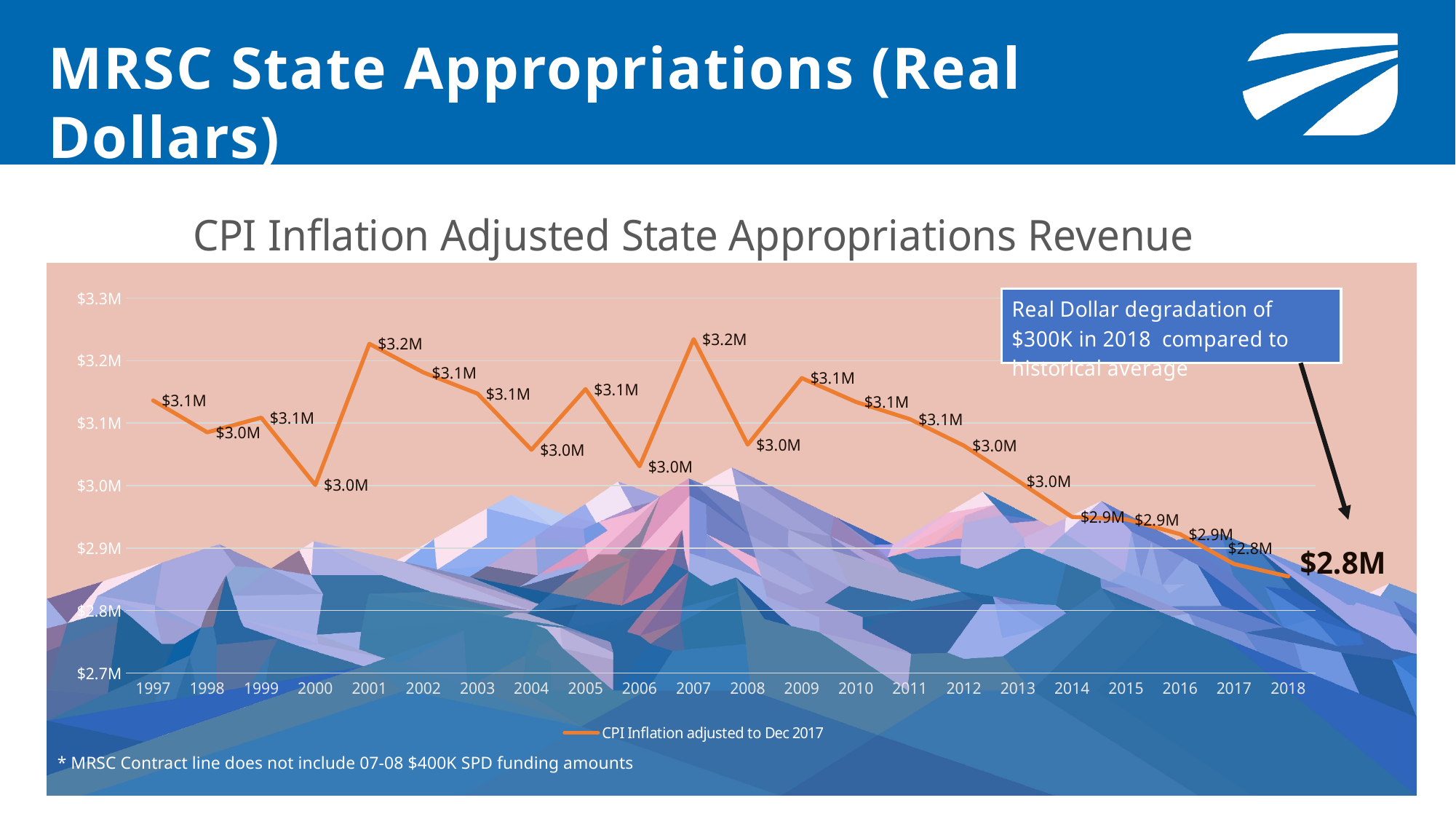
What is the CPI inflation adjusted value for 2001? $3.2M Which is larger, the value for 2001 or the value for 2004? 2001 What is the CPI inflation adjusted value for 2018? $2.8M What is the difference between the value for 2001 and the value for 2018? $0.4M What is the title of the chart? CPI Inflation Adjusted State Appropriations Revenue How many years are plotted on the x axis? 22 Is the value for 2018 greater or less than $2.9M? less Overall, do the values rise or fall from 1997 to 2018? fall What type of chart is shown on the slide? line chart Is the value for 2007 greater or less than $3.2M? greater How many series does the legend list? 1 What is the CPI inflation adjusted value for 2014? $2.9M